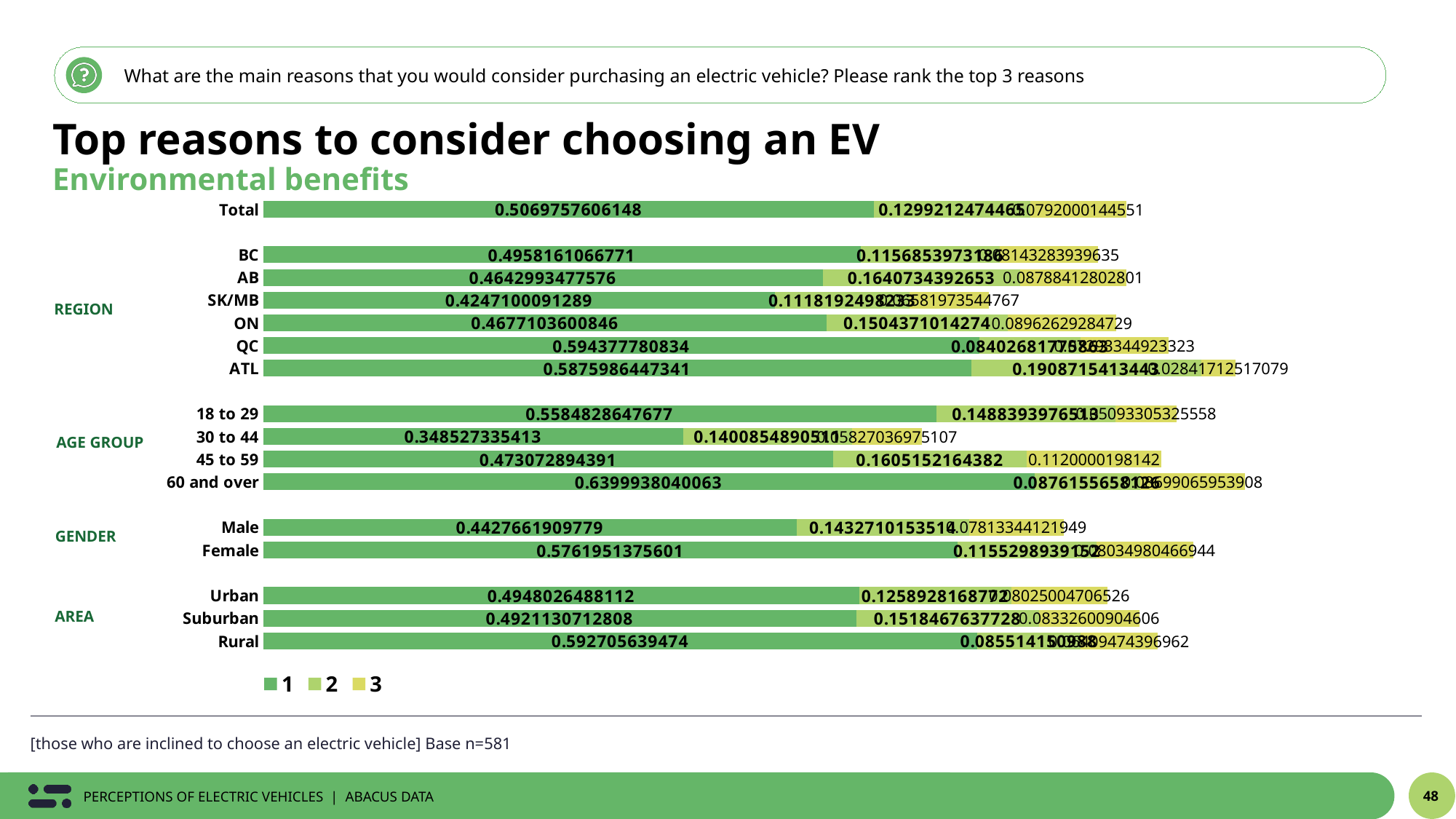
What is the value of series 3 for 45 to 59? 0.1120000198142 What kind of chart is shown on the slide? Stacked bar chart How many series does the legend list? 3 What is the subtitle shown above the chart? Environmental benefits What is the difference between the series 1 values for Female and Male? 0.1334289465822 What is the value of series 2 for ATL? 0.1908715413443 What is the value of series 1 for 30 to 44? 0.348527335413 Which category has the highest value for series 1? 60 and over What is the value of series 1 for Total? 0.5069757606148 Which category has the lowest value for series 1? 30 to 44 Which has the larger series 1 value, Male or Female? Female How many categories (rows) are plotted in the chart? 16